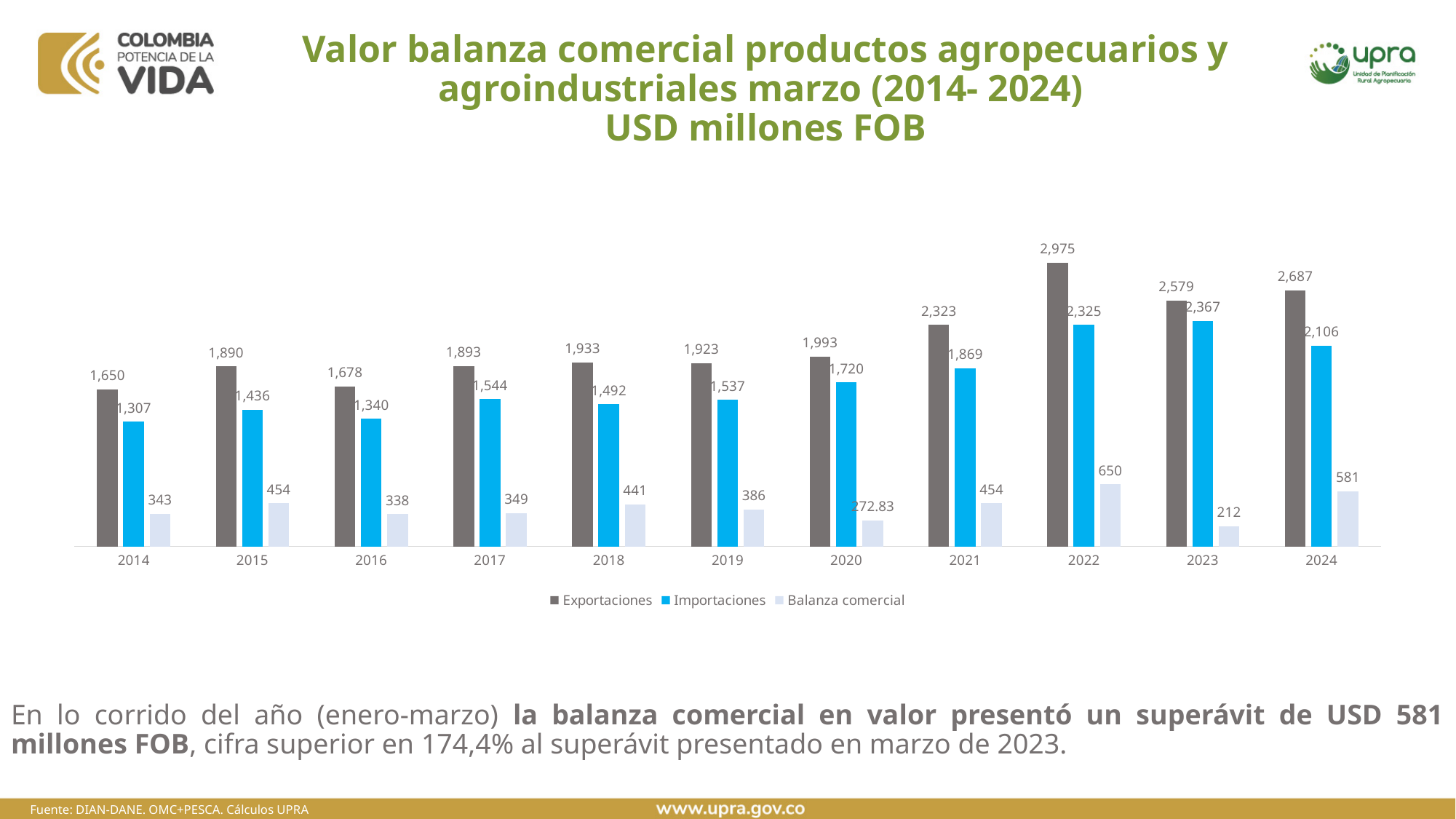
What is the value of Balanza comercial in 2020? 272.83 What is the difference between Exportaciones and Importaciones in 2024? 581 Which year has the highest Exportaciones value? 2022 Which is larger, Importaciones in 2023 or Importaciones in 2022? Importaciones in 2023 How many series does the legend list? 3 Which series is shown in blue in the legend? Importaciones Did the Balanza comercial value rise or fall from 2022 to 2023? Fall What kind of chart is shown on the slide? Bar chart What is the value of Importaciones in 2024? 2,106 What is the value of Exportaciones in 2022? 2,975 How many years are shown on the x axis? 11 Which year has the lowest Balanza comercial value? 2023